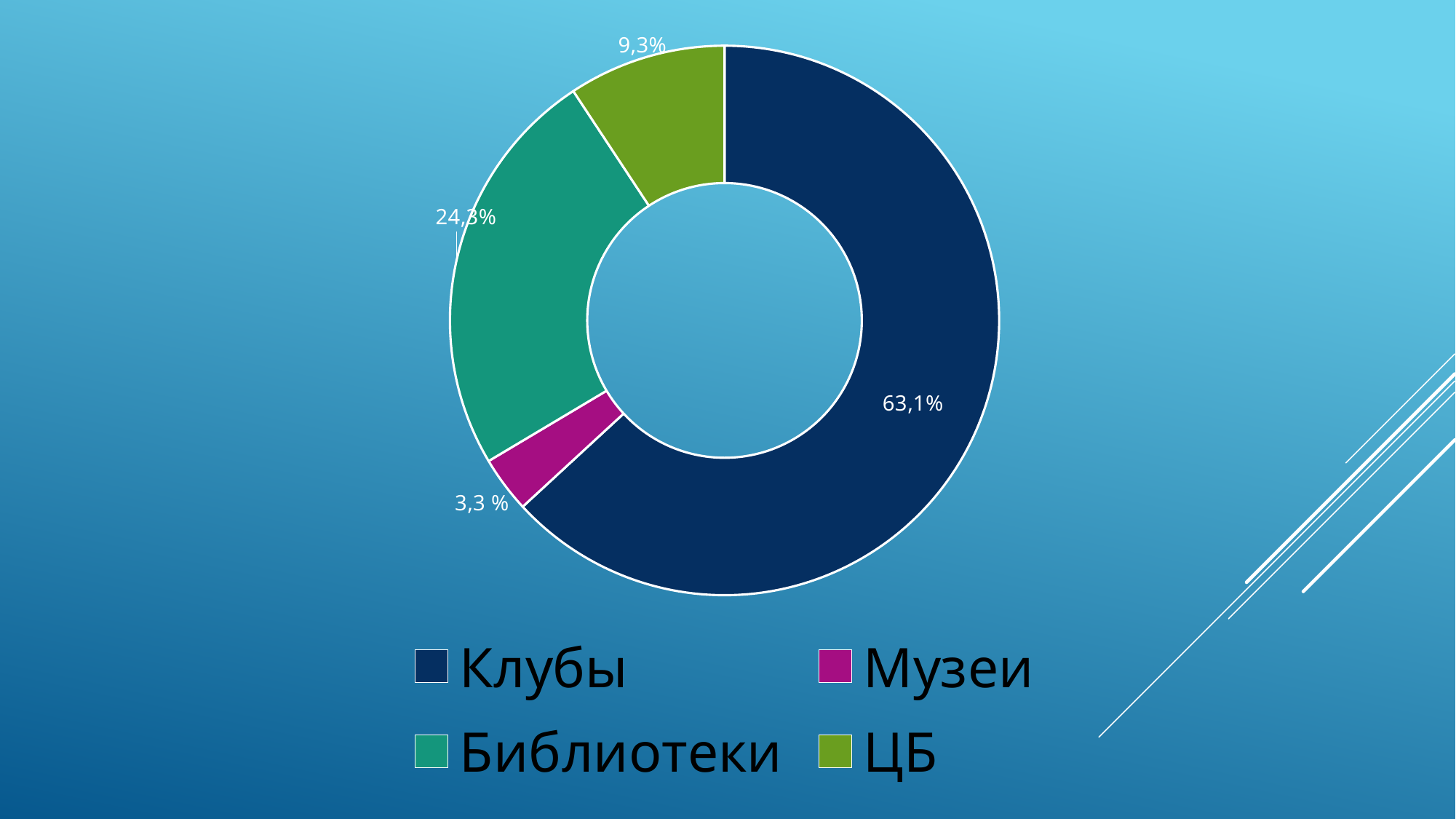
Which colour represents Музеи in the legend? magenta Which category has the largest slice of the pie? Клубы Which is larger, the share for Библиотеки or the share for ЦБ? Библиотеки Which category has the smallest slice of the pie? Музеи How many categories are shown in the pie chart? 4 What percentage is shown for Музеи? 3,3 % What value is labelled on the ЦБ slice? 9,3% What is the difference in percentage points between Клубы and Библиотеки? 38,8% What kind of chart is shown on the slide? doughnut chart What is the difference in percentage points between Клубы and ЦБ? 53,8% What share of the pie chart does Клубы account for? 63,1% What percentage is shown for Библиотеки? 24,3%